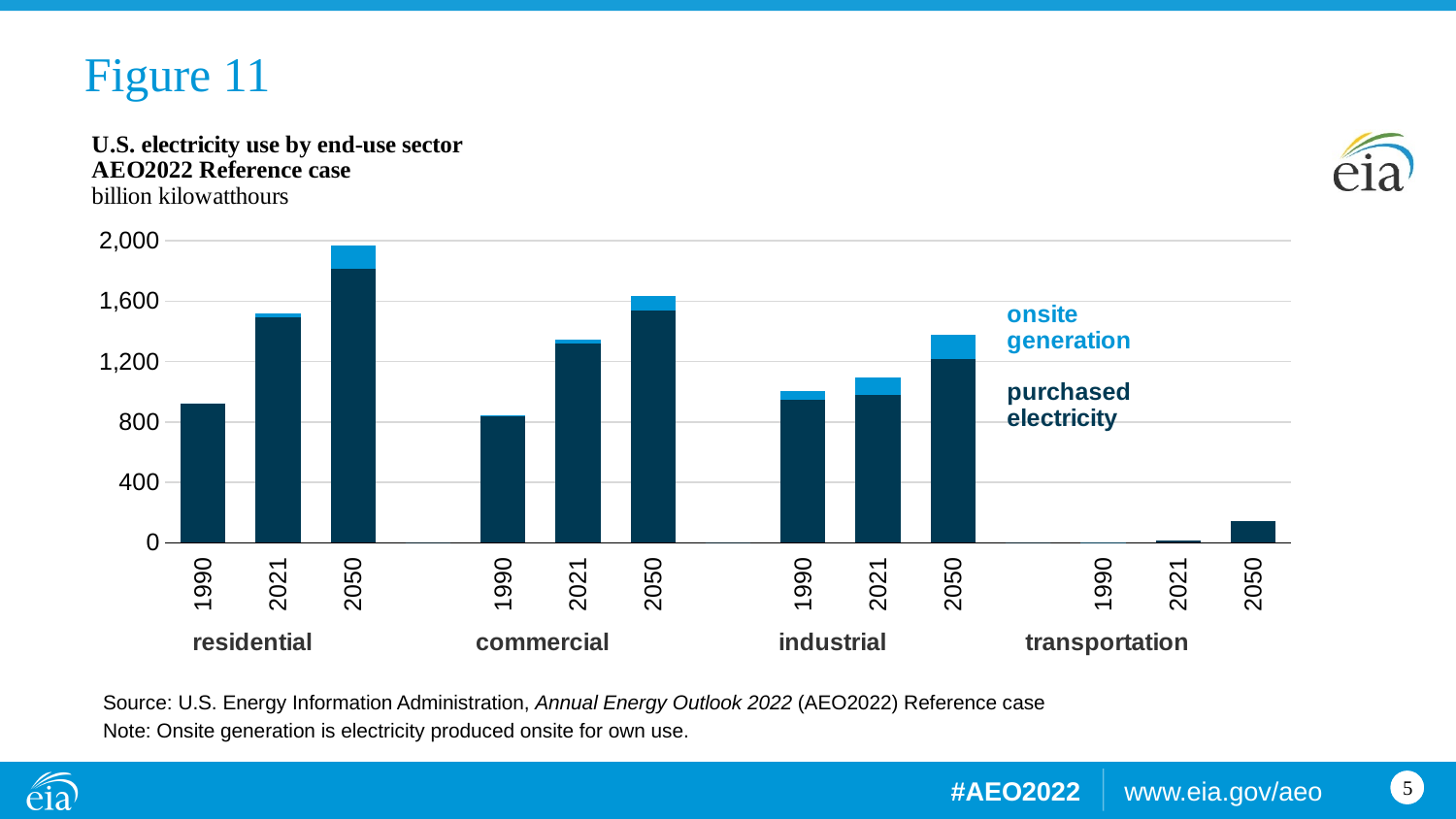
Which sector and year has the tallest bar? residential, 2050 Which is larger in 2021, the total for residential or the total for commercial? residential Which sector has the lowest electricity use in every year shown? transportation Is the value for transportation in 2050 greater or less than 400? less How many end-use sectors are shown on the x axis? 4 How many bars are plotted in the chart in total? 12 Is the total value for industrial in 2050 greater or less than 1,200? greater What kind of chart is shown on the slide? stacked bar chart Is the total value for residential in 2050 greater or less than 1,600? greater What are the two series shown in the chart? onsite generation and purchased electricity How many series does the chart's legend list? 2 Does residential electricity use rise or fall from 1990 to 2050? rise